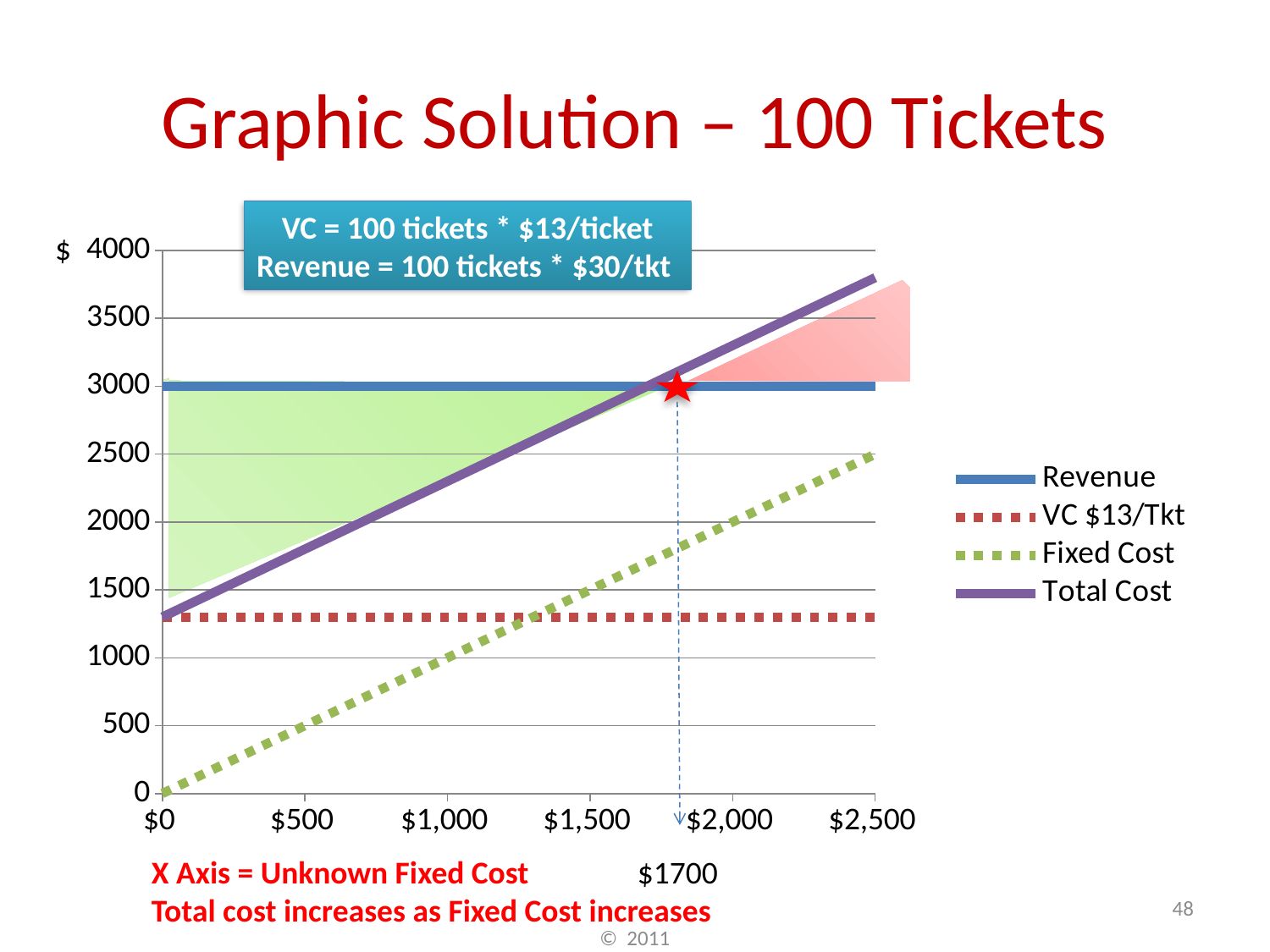
Which series has the lowest value at $0 on the x axis? Fixed Cost What kind of chart is shown on the slide? line chart At a fixed cost of $2,500, which is larger, Total Cost or Revenue? Total Cost Does the Revenue line rise, fall, or stay flat across the x axis? stay flat Is the value of the VC $13/Tkt line greater or less than 1500? less At what fixed cost (marked with a star) does Total Cost equal Revenue? $1700 What are the four series listed in the legend? Revenue, VC $13/Tkt, Fixed Cost, Total Cost What is the value of the Fixed Cost line at $2,500 on the x axis? 2500 Does the Fixed Cost line rise or fall as the x axis increases? rise How many series does the legend list? 4 What is the value of the Revenue line? 3000 At a fixed cost of $0, which is larger, Revenue or Total Cost? Revenue